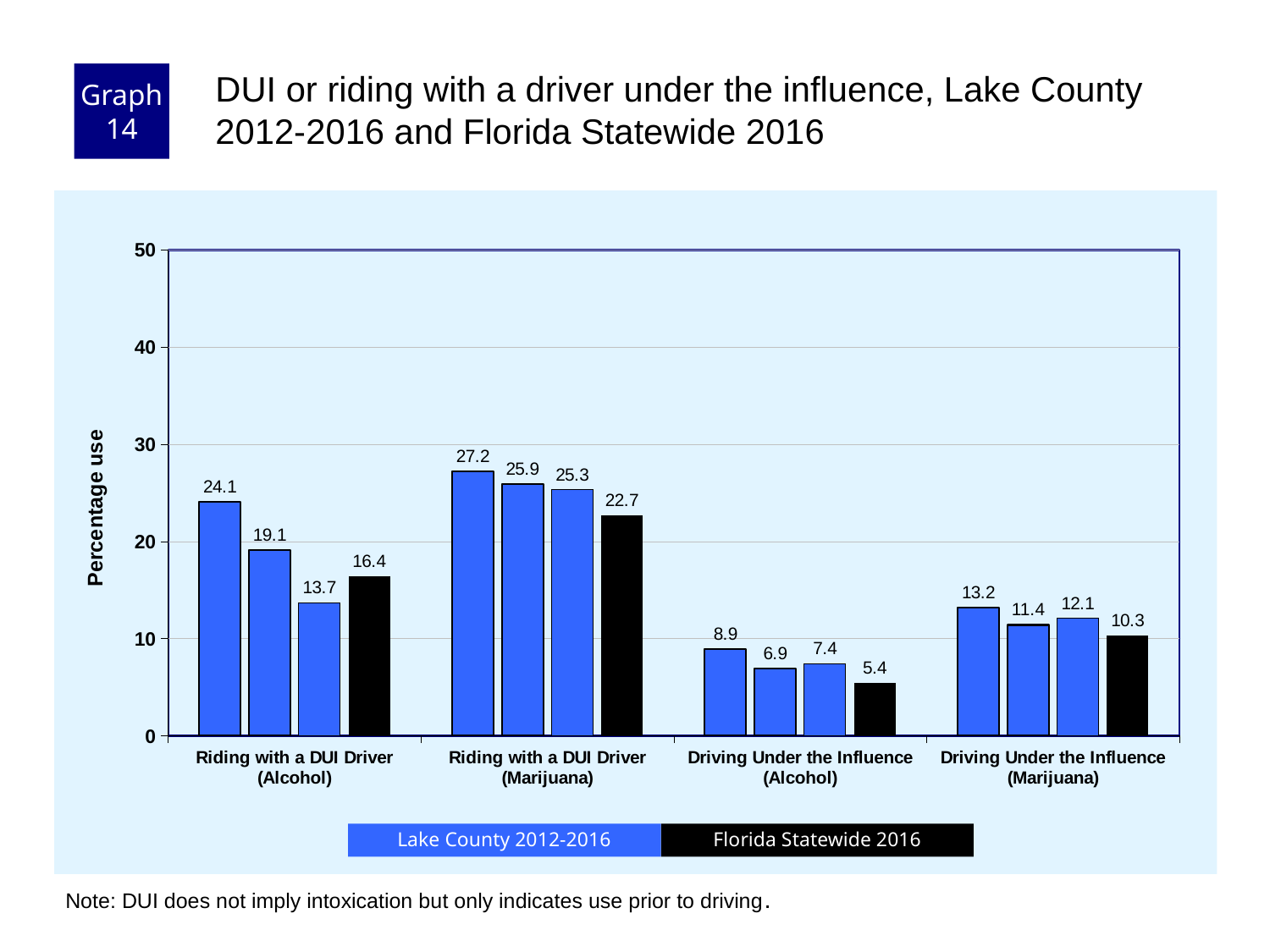
What is the value of the tallest bar in the Driving Under the Influence (Alcohol) group? 8.9 Is the Florida Statewide 2016 value for Riding with a DUI Driver (Marijuana) greater or less than 20? greater Which category has the highest Florida Statewide 2016 value? Riding with a DUI Driver (Marijuana) Which category has the lowest Florida Statewide 2016 value? Driving Under the Influence (Alcohol) How many categories are shown on the x axis? 4 How many series does the legend list? 2 What is the Florida Statewide 2016 value for Riding with a DUI Driver (Alcohol)? 16.4 Which is larger: the Florida Statewide 2016 value for Riding with a DUI Driver (Alcohol) or for Driving Under the Influence (Marijuana)? Riding with a DUI Driver (Alcohol) What kind of chart is shown on the slide? bar chart What is the difference between the Florida Statewide 2016 values for Riding with a DUI Driver (Marijuana) and Riding with a DUI Driver (Alcohol)? 6.3 What is the Florida Statewide 2016 value for Driving Under the Influence (Marijuana)? 10.3 What is the Florida Statewide 2016 value for Riding with a DUI Driver (Marijuana)? 22.7